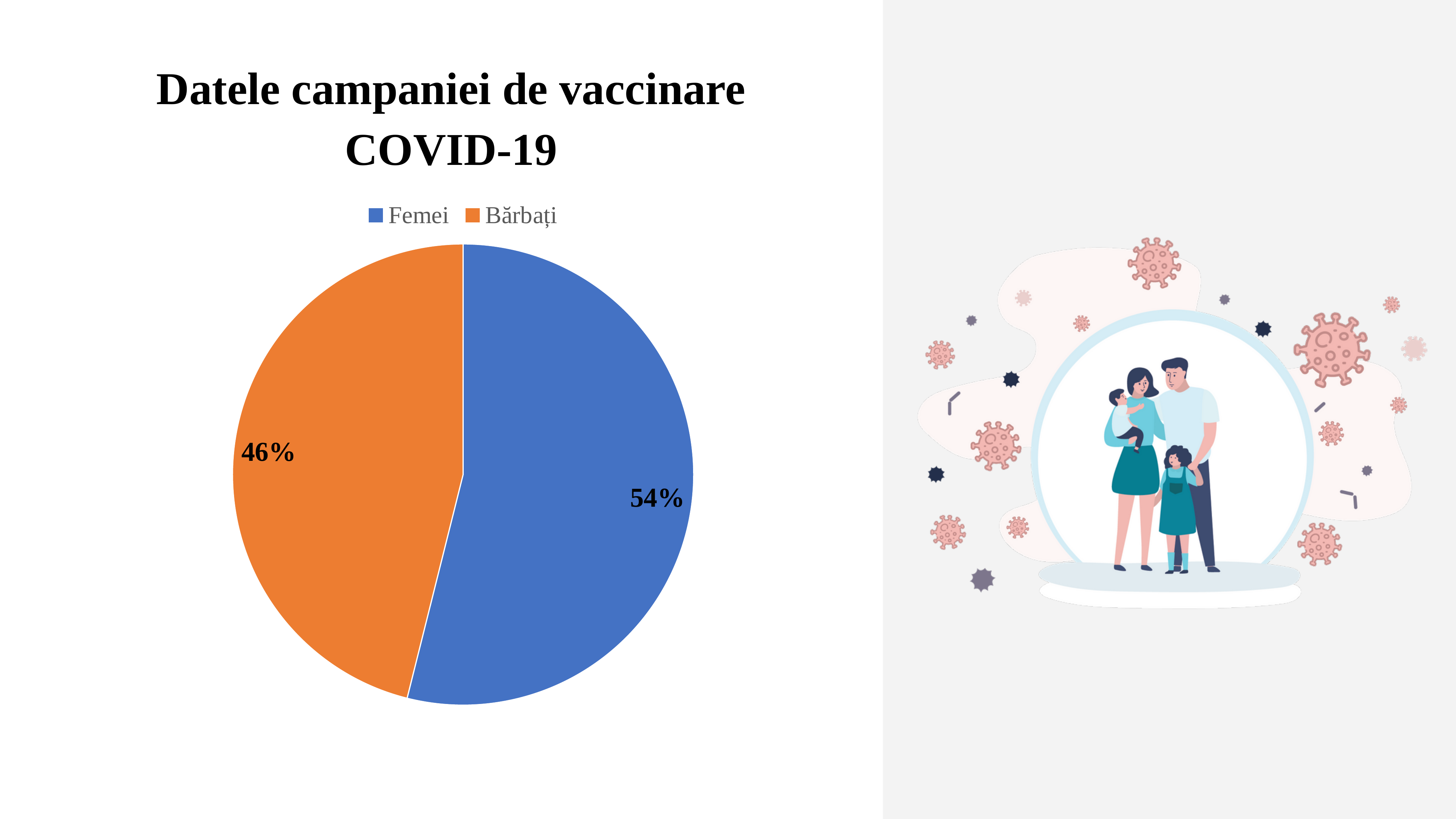
Which category has the largest slice of the pie? Femei How many slices does the pie chart have? 2 What colour is the Bărbați slice? orange What kind of chart is shown on the slide? pie chart What share of the pie does Bărbați have? 46% How many entries does the legend list? 2 What is the difference in percentage points between the Femei and Bărbați slices? 8 Which is larger, the Femei slice or the Bărbați slice? Femei What is the title of the chart? Datele campaniei de vaccinare COVID-19 Which category has the smallest slice of the pie? Bărbați What share of the pie does Femei have? 54%